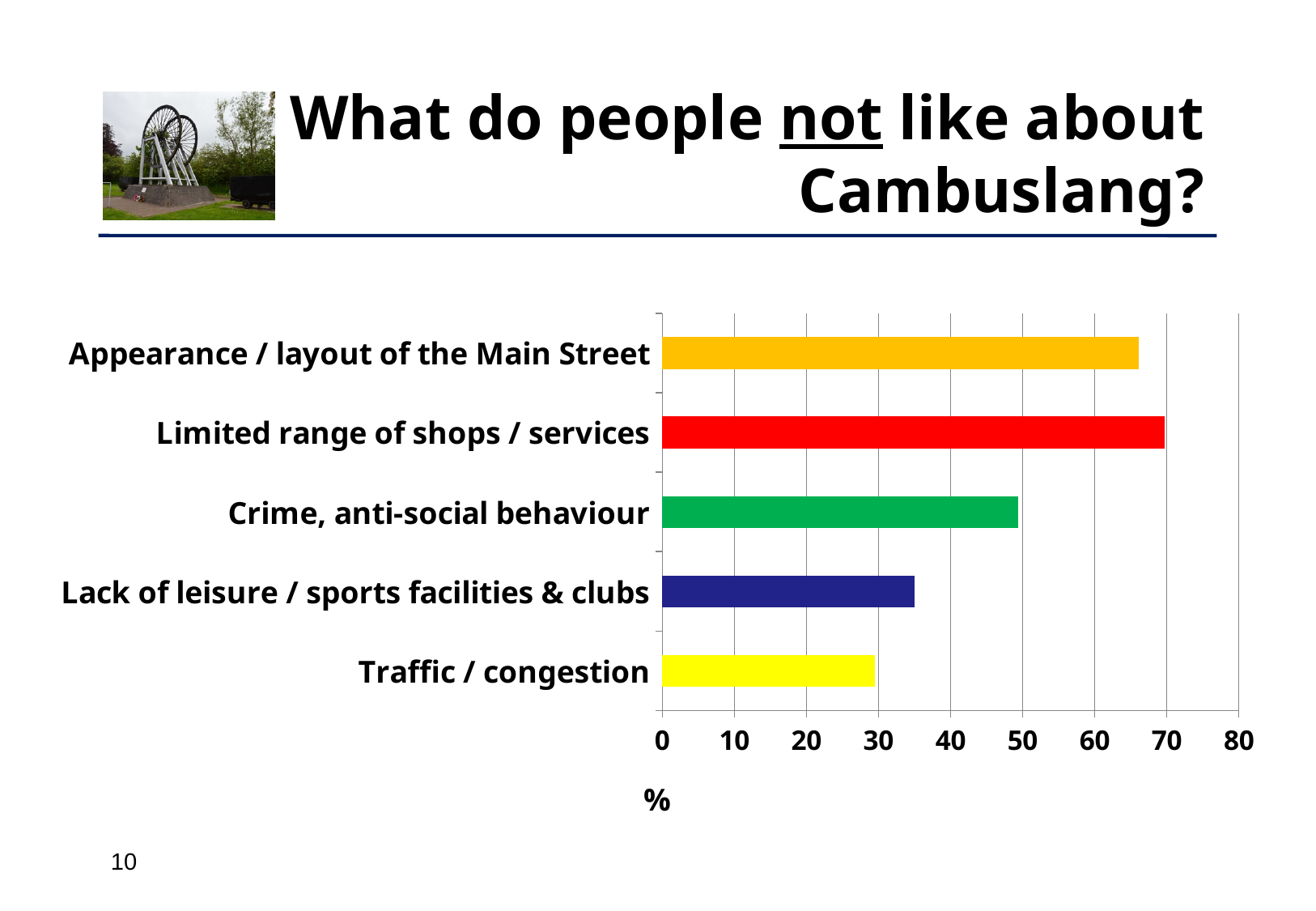
Is the value for Appearance / layout of the Main Street greater or less than 60? greater How many categories are shown in the chart? 5 Which category has the highest value in the chart? Limited range of shops / services Which has a larger value: Appearance / layout of the Main Street or Traffic / congestion? Appearance / layout of the Main Street Which category has the lowest value in the chart? Traffic / congestion Is the value for Traffic / congestion greater or less than 20? greater Which has a larger value: Crime, anti-social behaviour or Lack of leisure / sports facilities & clubs? Crime, anti-social behaviour What colour is the bar for Crime, anti-social behaviour? green What is the label on the horizontal axis of the chart? % Is the value for Crime, anti-social behaviour greater or less than 40? greater What kind of chart is shown on the slide? bar chart